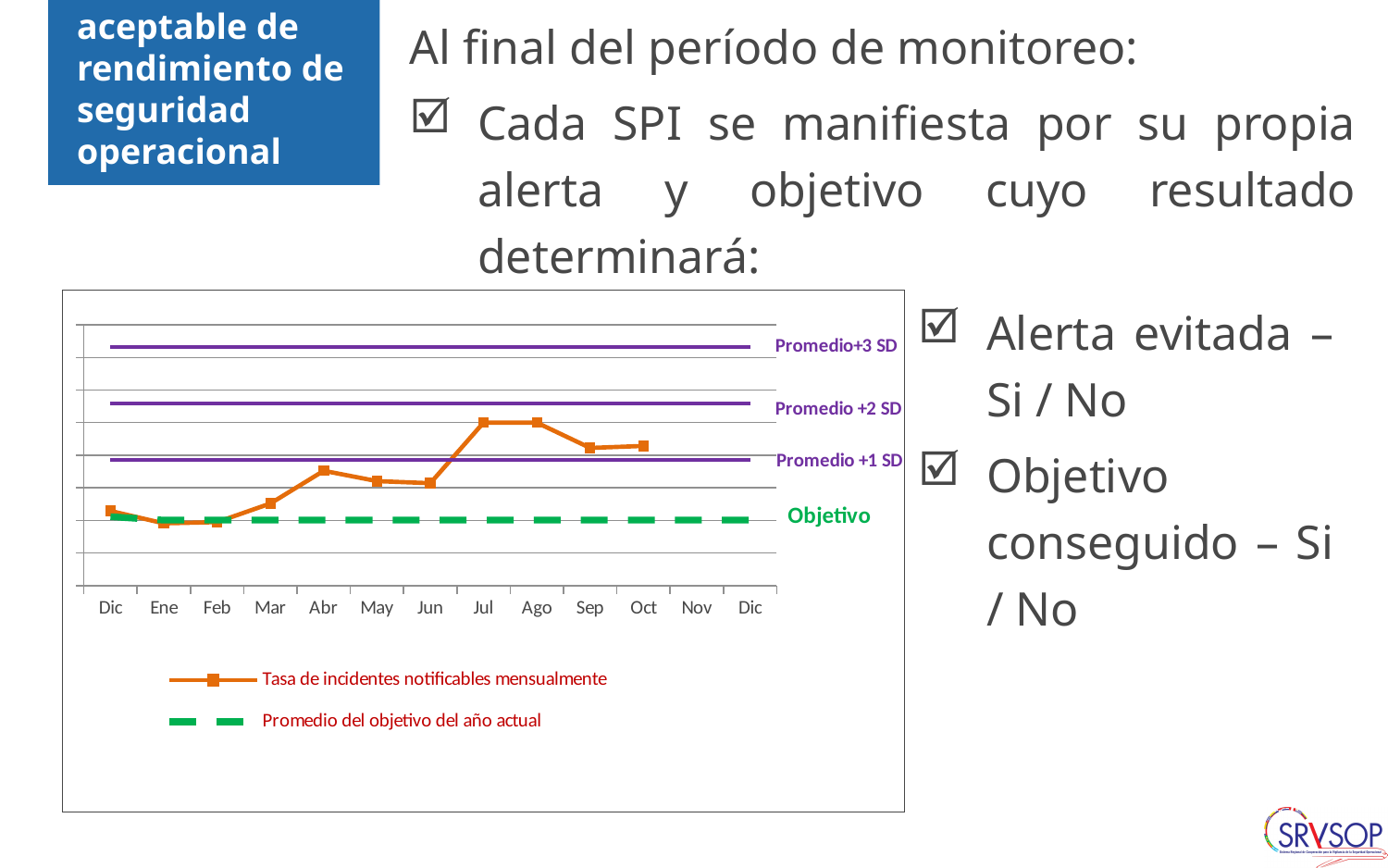
What label is given to the green dashed line in the chart? Objetivo What kind of chart is shown on the slide? line chart In Jul, is the monthly notifiable incident rate above or below the Promedio +1 SD line? above In Jul, is the monthly notifiable incident rate above or below the Promedio +2 SD line? below How many months have a plotted value for the monthly notifiable incident rate? 11 Is the monthly notifiable incident rate higher in Abr or in Feb? Abr Does the monthly notifiable incident rate rise or fall from Feb to Jul? rise How many series does the chart legend list? 2 Does the monthly notifiable incident rate rise or fall from Ago to Sep? fall How many month categories are shown on the x axis of the chart? 13 What is the first series listed in the chart legend? Tasa de incidentes notificables mensualmente